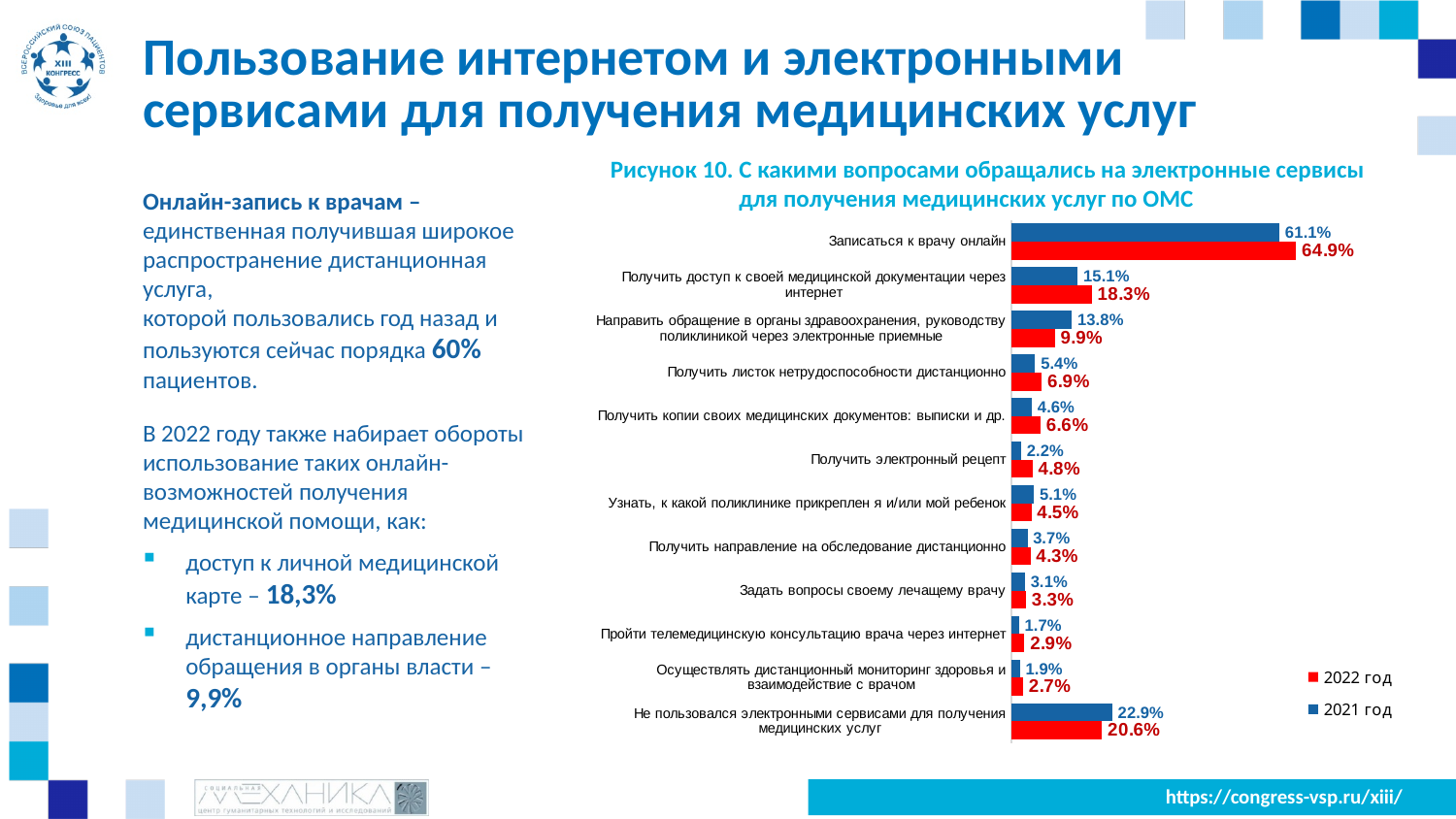
For "Получить электронный рецепт", which year has the larger value, 2021 год or 2022 год? 2022 год How many series does the chart legend list? 2 How many categories are shown in the chart? 12 What is the 2021 год value for "Получить доступ к своей медицинской документации через интернет"? 15.1% What type of chart is shown on the slide? Bar chart Which category has the highest 2022 год value? Записаться к врачу онлайн What is the 2022 год value for "Записаться к врачу онлайн"? 64.9% Which colour represents the 2022 год series in the chart? Red What is the 2022 год value for "Направить обращение в органы здравоохранения, руководству поликлиникой через электронные приемные"? 9.9% Which category has the lowest 2021 год value? Пройти телемедицинскую консультацию врача через интернет What is the difference between the 2022 год and 2021 год values for "Записаться к врачу онлайн"? 3.8% For "Не пользовался электронными сервисами для получения медицинских услуг", which year has the larger value, 2021 год or 2022 год? 2021 год